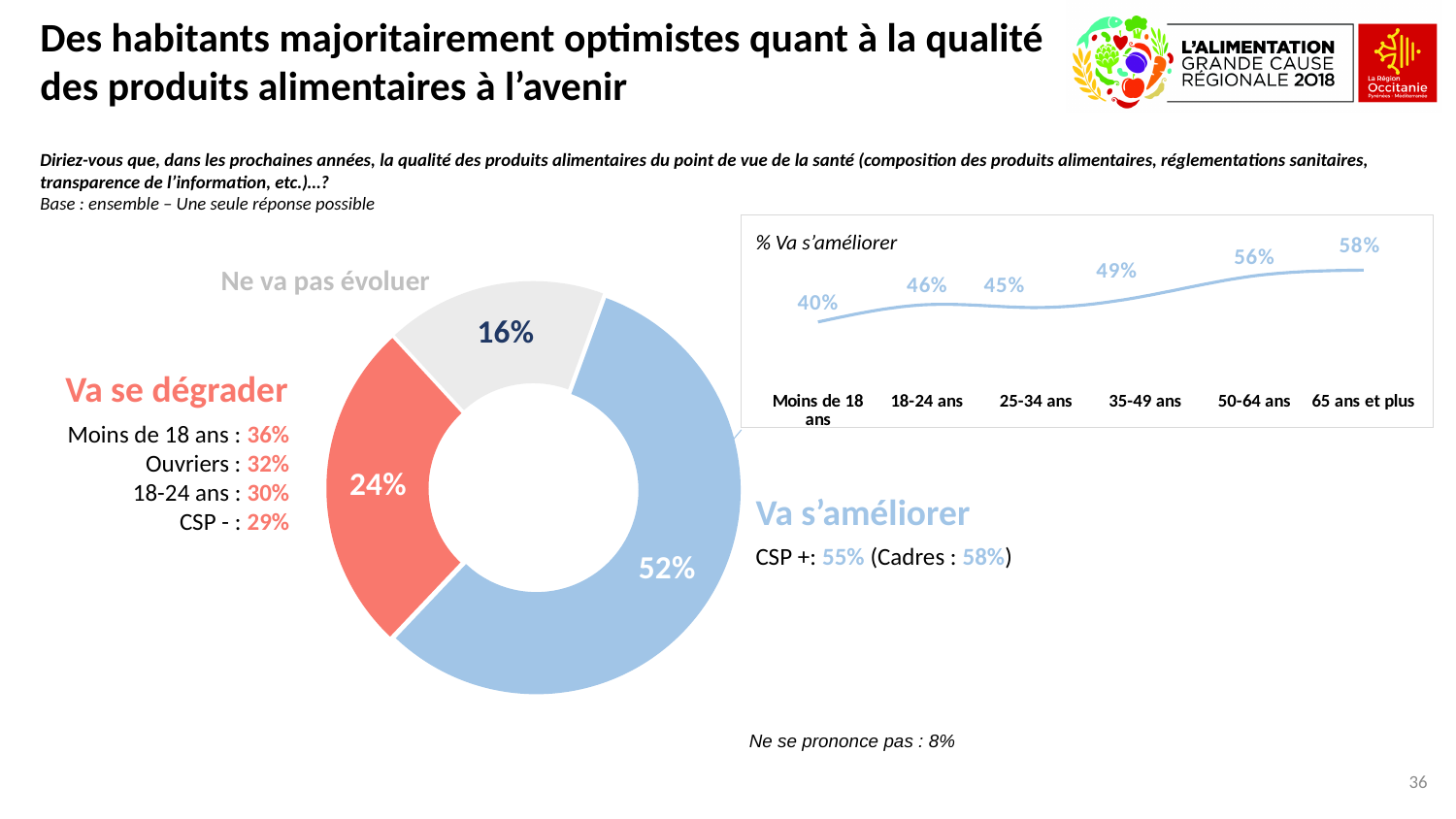
In the donut chart, what share of respondents answered "Va s'améliorer"? 52% In the donut chart, what share of respondents answered "Ne va pas évoluer"? 16% In the donut chart, what is the difference in percentage points between "Va s'améliorer" and "Va se dégrader"? 28 points In the line chart "% Va s'améliorer", is the value for "18-24 ans" larger or smaller than the value for "25-34 ans"? Larger In the line chart "% Va s'améliorer", which age group has the lowest value? Moins de 18 ans In the line chart "% Va s'améliorer", what is the value for "65 ans et plus"? 58% In the donut chart, what share of respondents answered "Va se dégrader"? 24% What kind of chart is the chart on the left of the slide? Donut (pie) chart In the line chart "% Va s'améliorer", what is the value for "Moins de 18 ans"? 40% In the donut chart, which response has the smallest share? Ne va pas évoluer In the donut chart, which response has the largest share? Va s'améliorer In the line chart "% Va s'améliorer", how many age groups are plotted? 6